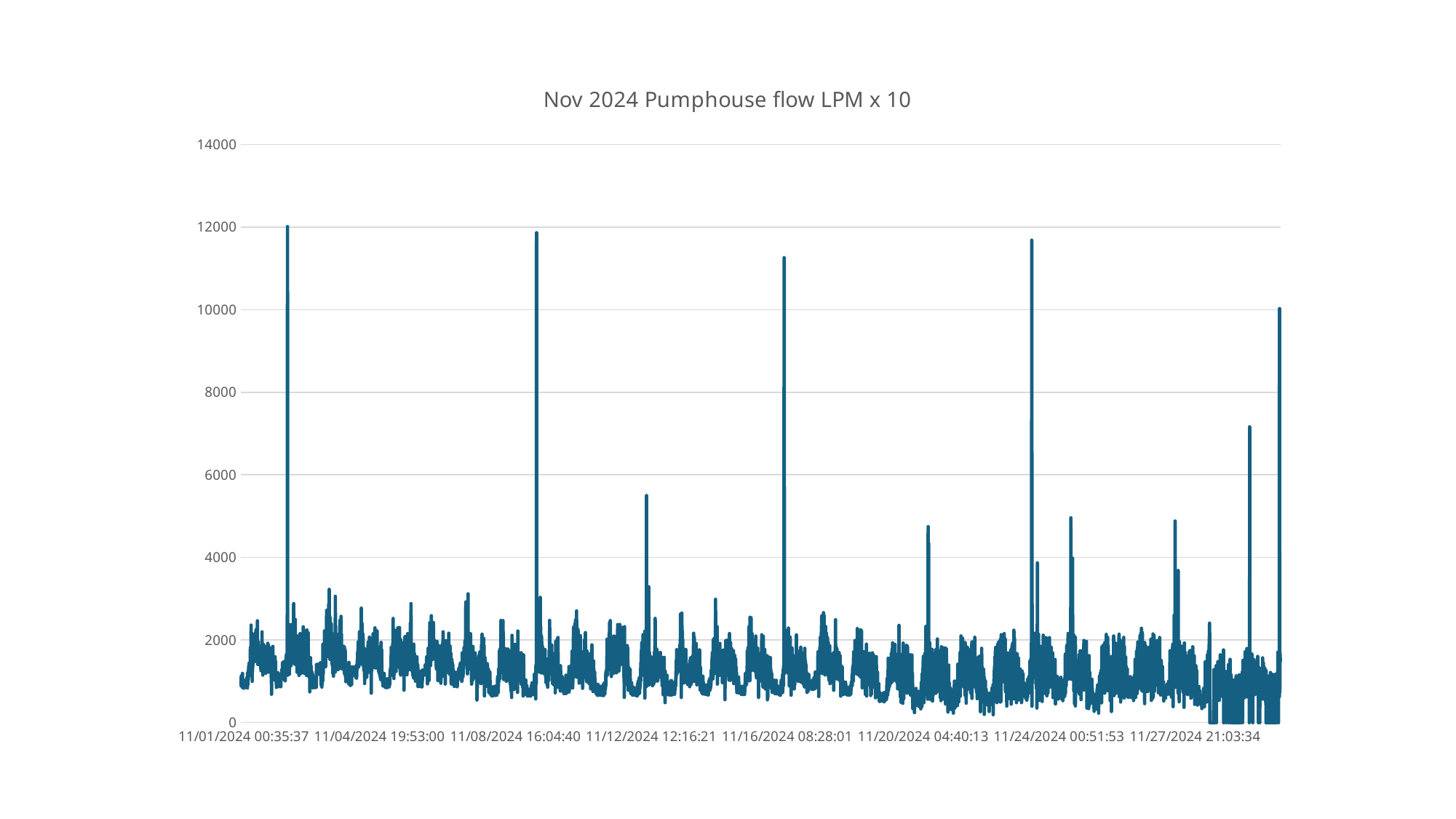
What is the highest value shown on the vertical axis? 14000 Is the tallest spike near 11/01/2024 greater or less than 10000? greater How many lines (data series) are plotted on the chart? 1 Is the spike shortly after 11/27/2024 21:03:34 greater or less than 6000? greater What kind of chart is shown on the slide? line chart Is the spike just before 11/08/2024 16:04:40 greater or less than 10000? greater What is the title of the chart? Nov 2024 Pumphouse flow LPM x 10 Is the spike near 11/24/2024 00:51:53 larger than the spike near 11/20/2024 04:40:13? yes How many date labels are shown along the horizontal axis? 8